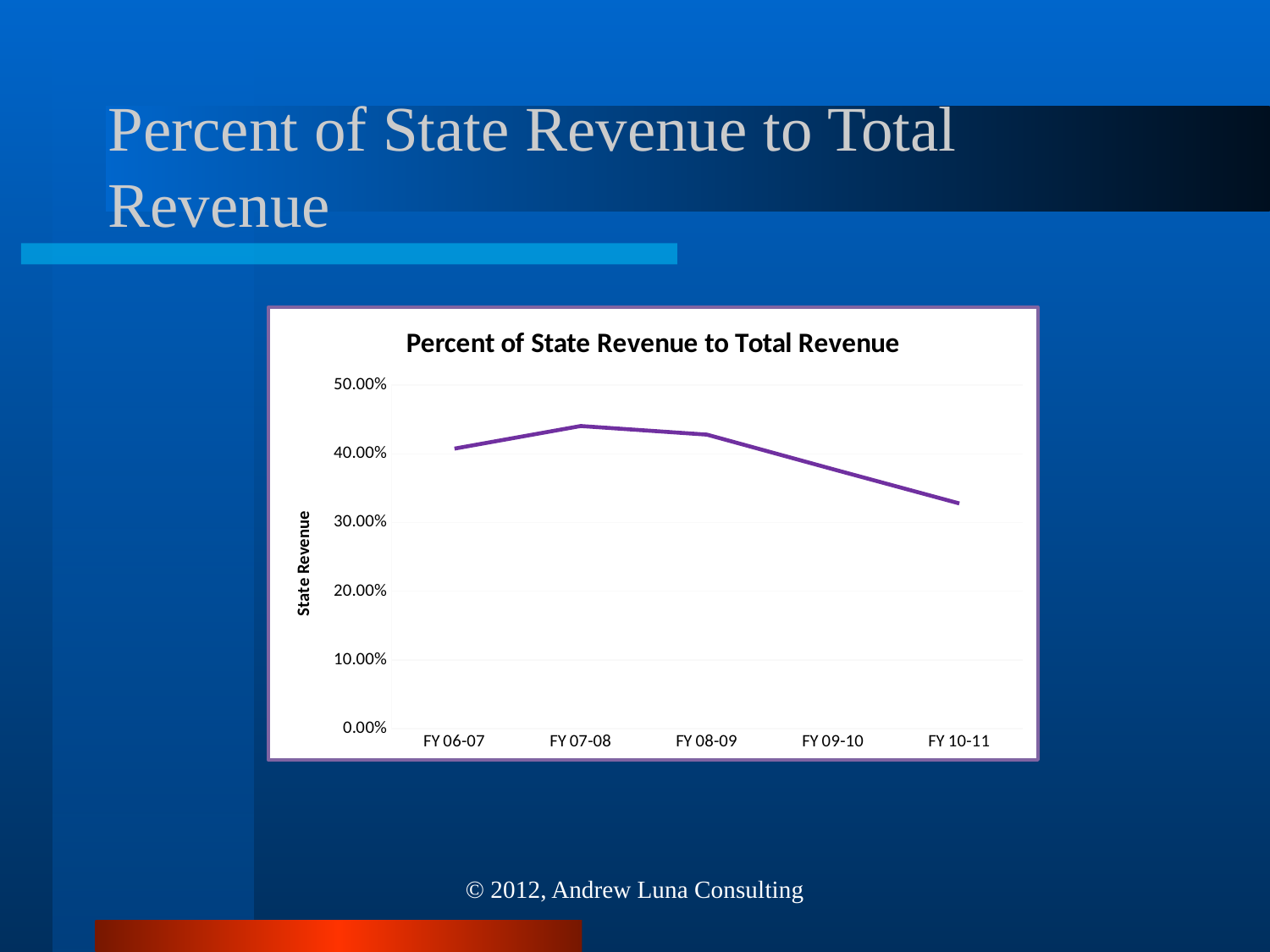
What is the title of the chart? Percent of State Revenue to Total Revenue Is the value for FY 10-11 greater or less than 40.00%? less What kind of chart is shown on the slide? line chart Which fiscal year has the lowest percent of state revenue to total revenue? FY 10-11 Is the value for FY 10-11 greater or less than 30.00%? greater How many fiscal years are plotted on the x axis? 5 Which fiscal year has the highest percent of state revenue to total revenue? FY 07-08 Which is larger, the value for FY 06-07 or the value for FY 10-11? FY 06-07 Is the value for FY 07-08 greater or less than 40.00%? greater Do the values rise or fall from FY 07-08 to FY 10-11? fall What is the label on the vertical axis of the chart? State Revenue